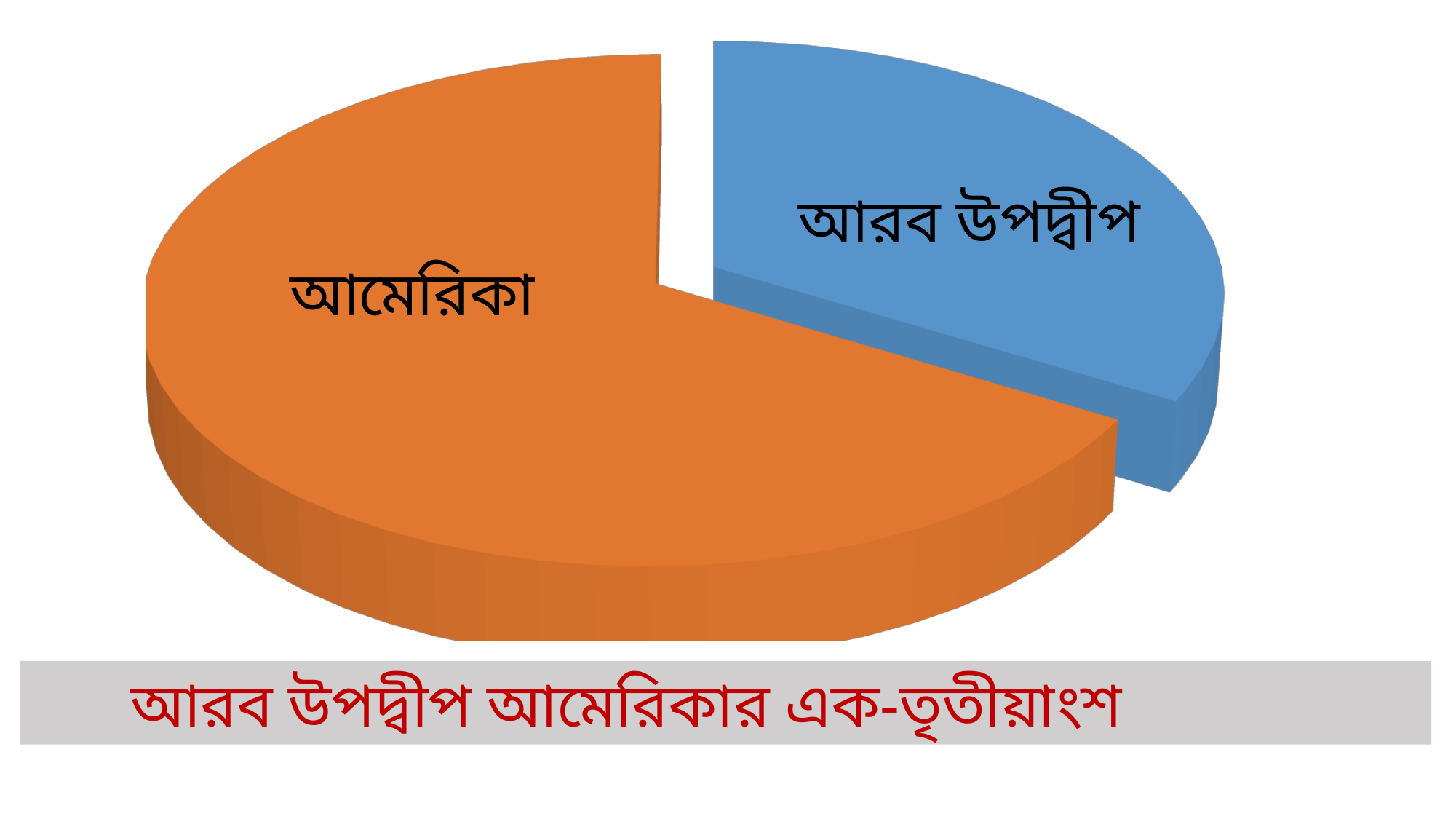
Which slice of the pie chart is the smallest? আরব উপদ্বীপ Which is larger in the pie chart, আমেরিকা or আরব উপদ্বীপ? আমেরিকা What colour is the আরব উপদ্বীপ slice of the pie chart? Blue Which slice of the pie chart is pulled out (exploded) from the rest of the pie? আরব উপদ্বীপ Which slice of the pie chart is the largest? আমেরিকা What kind of chart is shown on the slide? Pie chart What colour is the আমেরিকা slice of the pie chart? Orange How many slices does the pie chart have? 2